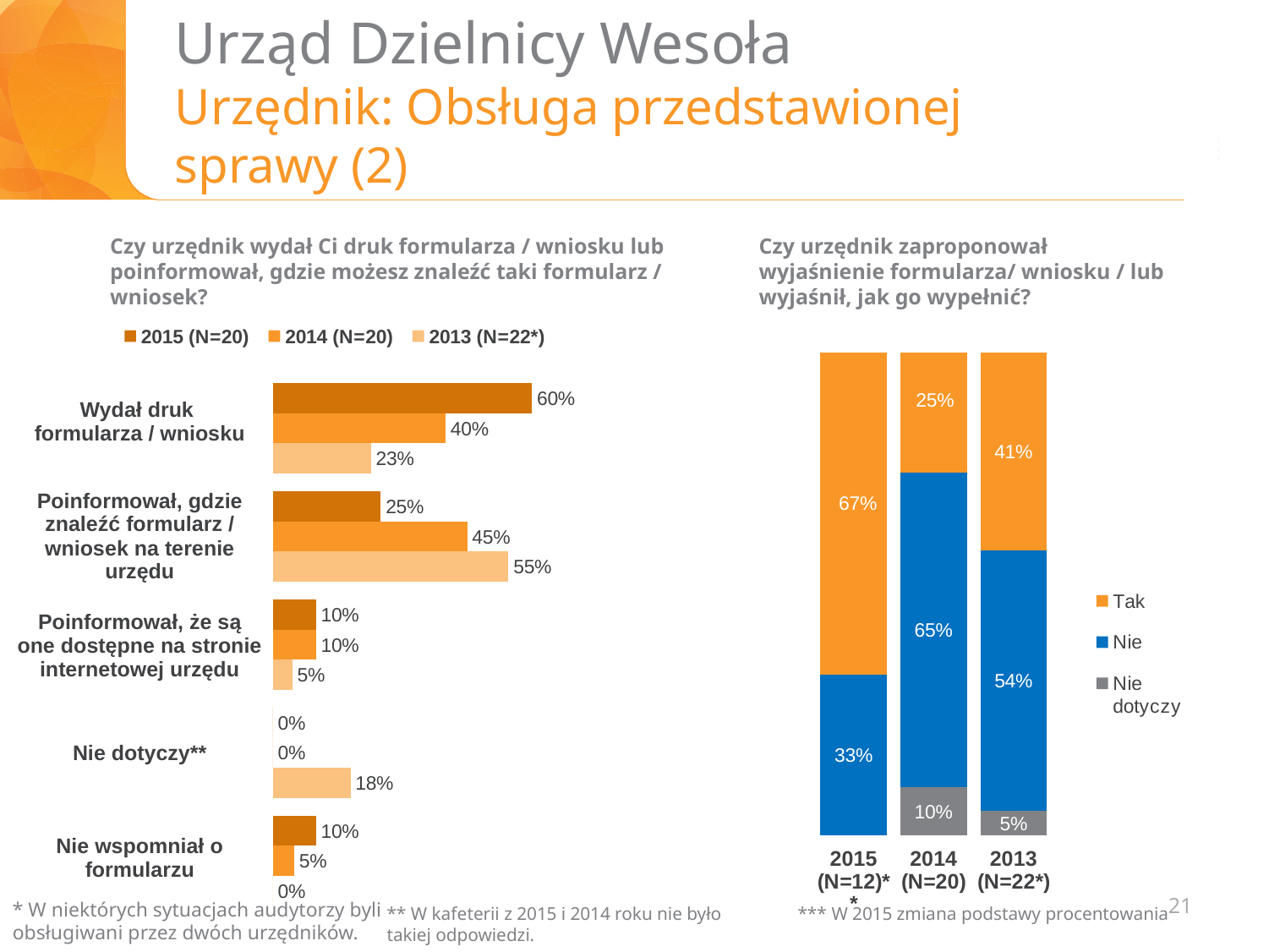
In the left chart, what is the value for "Nie dotyczy**" in 2013 (N=22*)? 18% In the right chart, which year has the highest "Nie" share? 2014 (N=20) In the left chart, which category has the highest value for the 2015 (N=20) series? Wydał druk formularza / wniosku In the left chart, what is the value for "Poinformował, gdzie znaleźć formularz / wniosek na terenie urzędu" in 2013 (N=22*)? 55% In the left chart, what is the difference between the 2015 and 2014 values for "Wydał druk formularza / wniosku"? 20 percentage points In the right chart, what is the "Tak" share for 2015 (N=12)*? 67% In the left chart, how many categories are shown? 5 In the right chart, is the "Tak" share for 2013 (N=22*) larger or smaller than the "Tak" share for 2014 (N=20)? Larger In the left chart ("Czy urzędnik wydał Ci druk formularza / wniosku..."), what is the value for "Wydał druk formularza / wniosku" in 2015 (N=20)? 60% In the right chart, what is the "Nie dotyczy" share for 2014 (N=20)? 10% In the left chart, how many series does the legend list? 3 What kind of chart is the right chart ("Czy urzędnik zaproponował wyjaśnienie formularza...")? Stacked bar chart